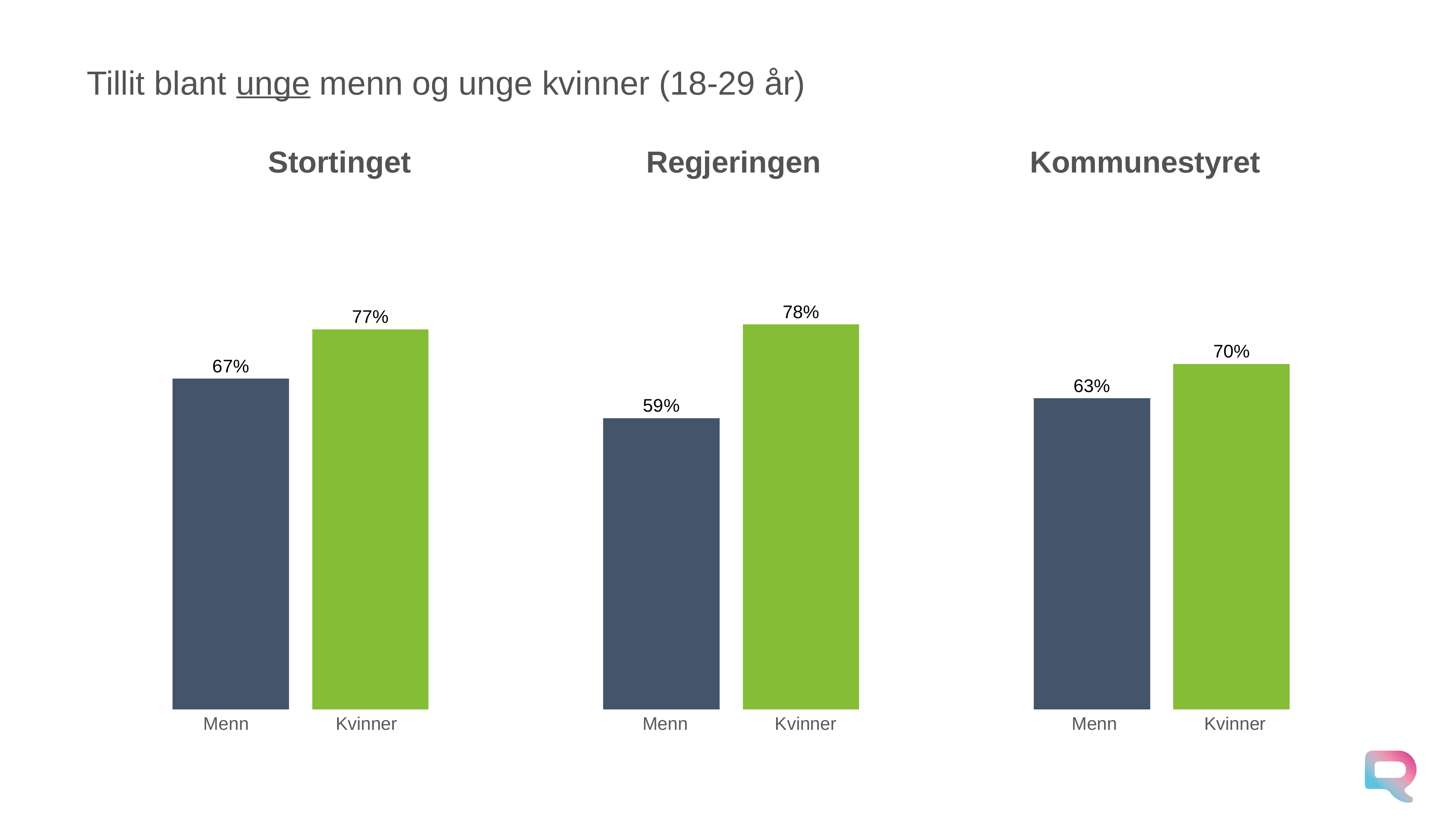
In the Regjeringen chart, what is the value for Menn? 59% In the Regjeringen chart, which category has the lowest value? Menn How many bars are shown in the Stortinget chart? 2 In the Stortinget chart, what is the value for Kvinner? 77% In the Stortinget chart, what is the difference between the values for Kvinner and Menn? 10 percentage points In the Regjeringen chart, what is the value for Kvinner? 78% In the Kommunestyret chart, what is the value for Menn? 63% In the Regjeringen chart, what is the difference between the values for Kvinner and Menn? 19 percentage points What kind of chart is the Kommunestyret chart? Bar chart In the Kommunestyret chart, what is the value for Kvinner? 70% In the Kommunestyret chart, which category has the higher value, Menn or Kvinner? Kvinner In the Stortinget chart, what is the value for Menn? 67%